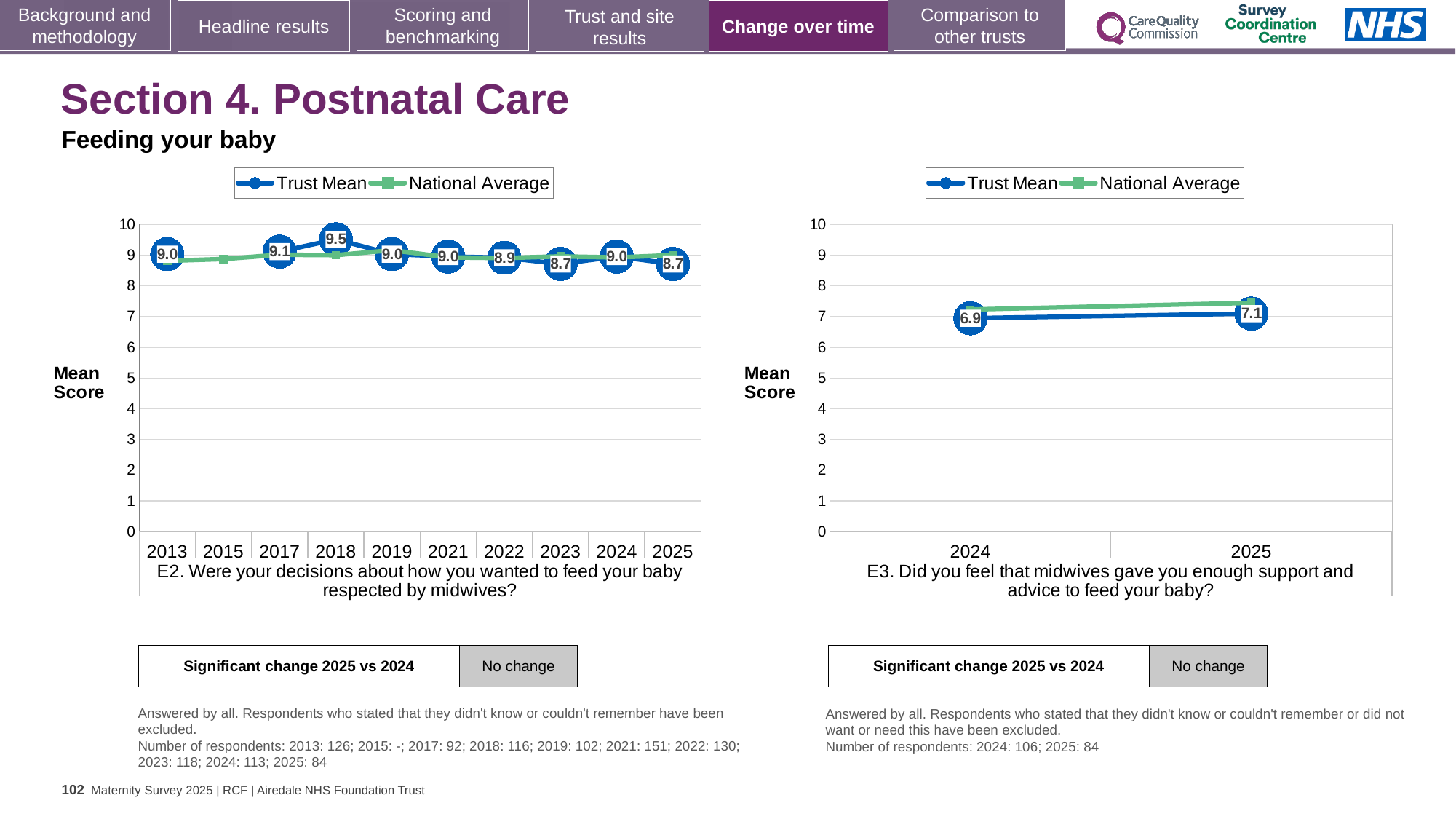
What kind of chart is the E2 chart (left)? line chart In the E2 chart (left), which year has the highest Trust Mean score? 2018 In the E3 chart (right), what is the Trust Mean score for 2025? 7.1 How many series does the legend of the E3 chart (right) list? 2 In the E2 chart (left), how many years are shown on the x axis? 10 In the E3 chart (right), did the Trust Mean score rise or fall from 2024 to 2025? rise In the E2 chart (left), what is the Trust Mean score for 2018? 9.5 In the E3 chart (right), what is the Trust Mean score for 2024? 6.9 In the E3 chart (right), what is the difference between the Trust Mean scores for 2025 and 2024? 0.2 In the E2 chart (left), is the Trust Mean score for 2023 greater or less than 8? greater In the E2 chart (left), what is the Trust Mean score for 2025? 8.7 In the E2 chart (left), what is the difference between the Trust Mean scores for 2018 and 2025? 0.8